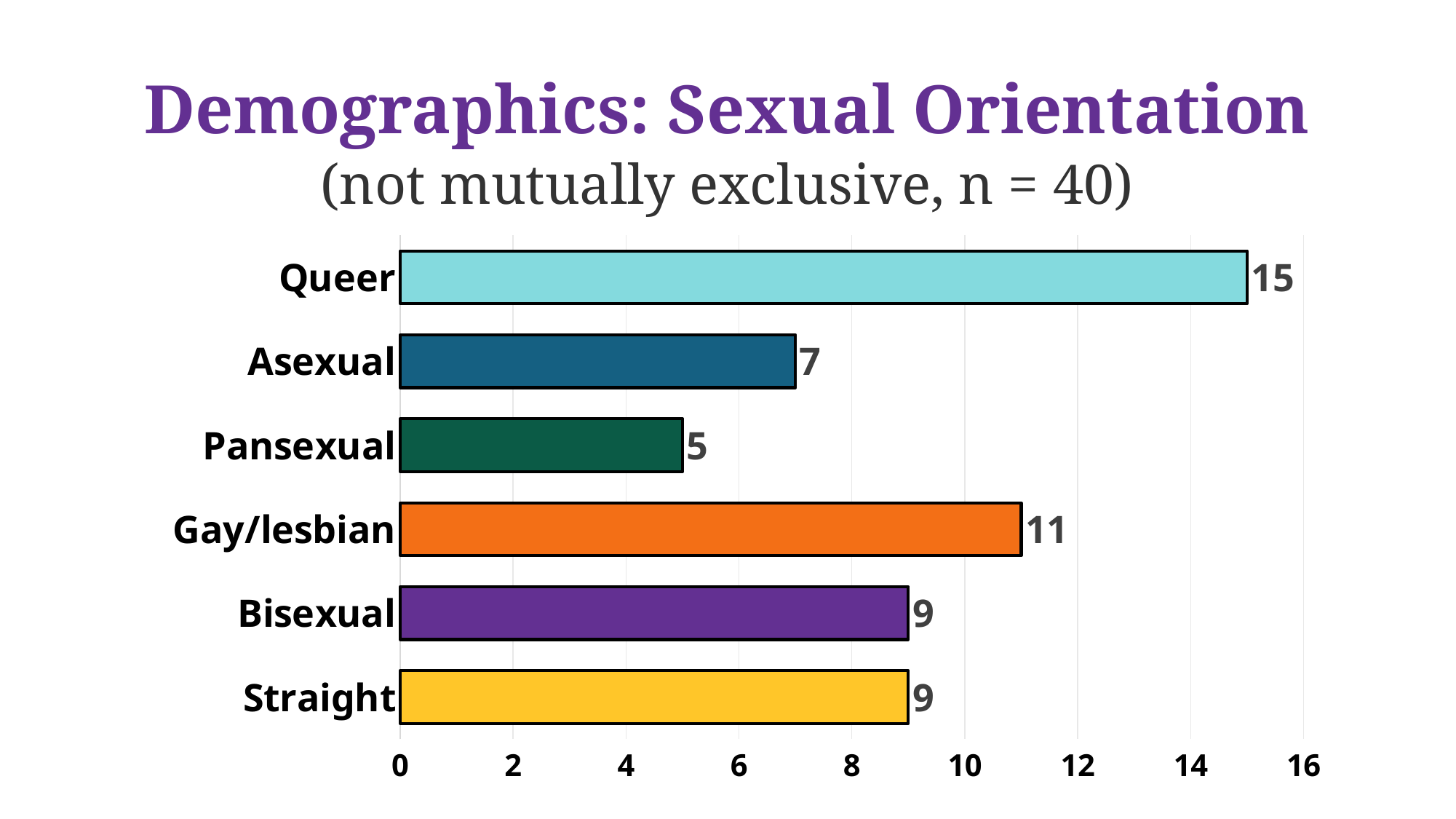
How many categories are shown in the chart? 6 What is the difference between the values for Queer and Gay/lesbian? 4 Which category has the lowest value? Pansexual What is the difference between the values for Asexual and Pansexual? 2 What is the title of the chart? Demographics: Sexual Orientation What is the value for Pansexual? 5 What is the value for Queer? 15 What kind of chart is shown on the slide? Bar chart Which category has the highest value? Queer Which is larger, the value for Bisexual or the value for Asexual? Bisexual What is the value for Gay/lesbian? 11 What is the value for Asexual? 7